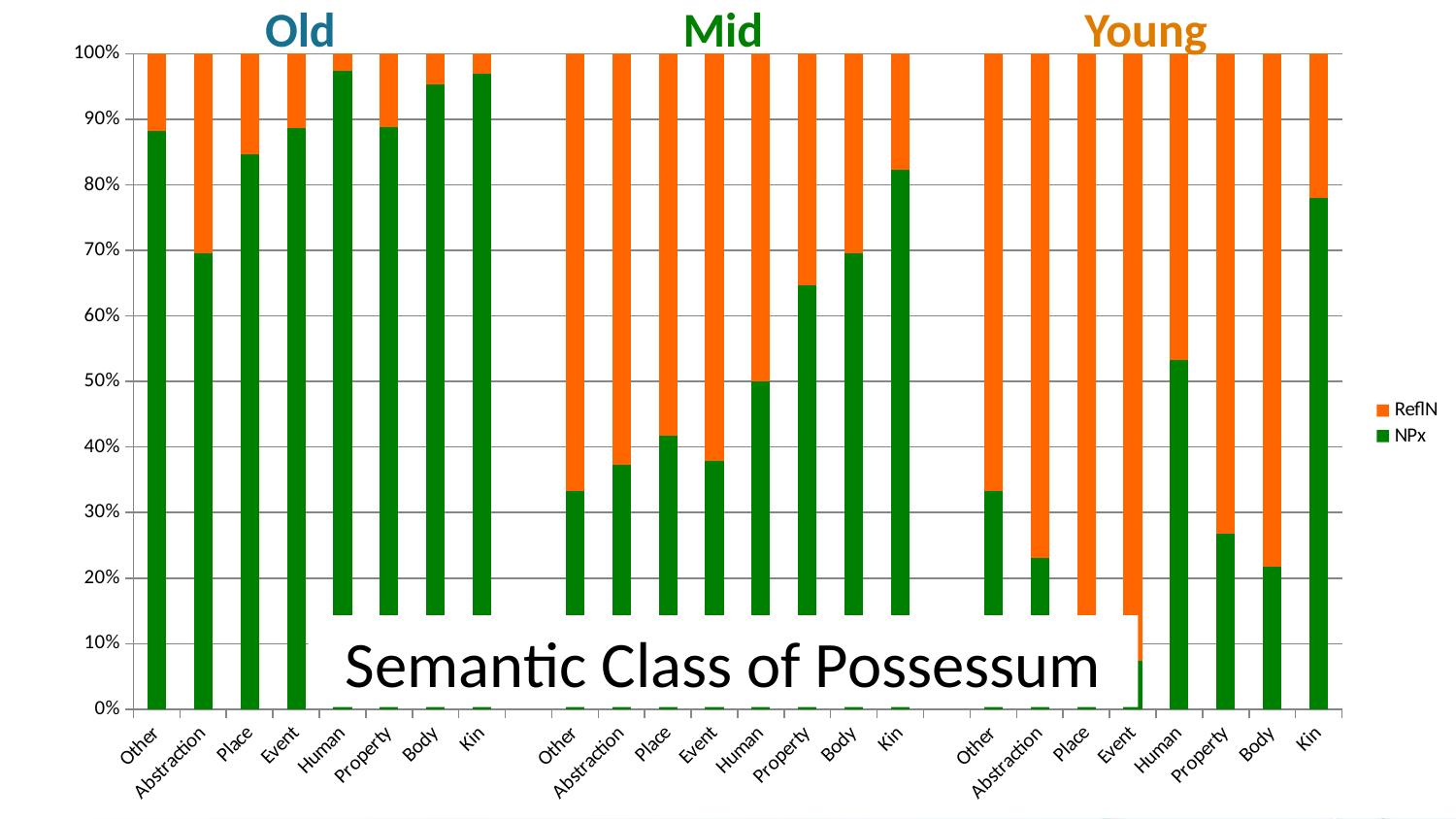
In the Young group, is the NPx share for Abstraction greater or less than 30%? less What kind of chart is shown on the slide? bar chart In the Mid group, is the NPx share for Kin greater or less than 70%? greater How many age groups (Old, Mid, Young) are shown on the chart? 3 What is the title shown on the chart? Semantic Class of Possessum How many semantic class categories are plotted within each age group? 8 What are the two series named in the legend? ReflN and NPx In the Old group, is the NPx share for Abstraction greater or less than 60%? greater How many series does the legend list? 2 In the Old group, which has the larger NPx share: Human or Abstraction? Human